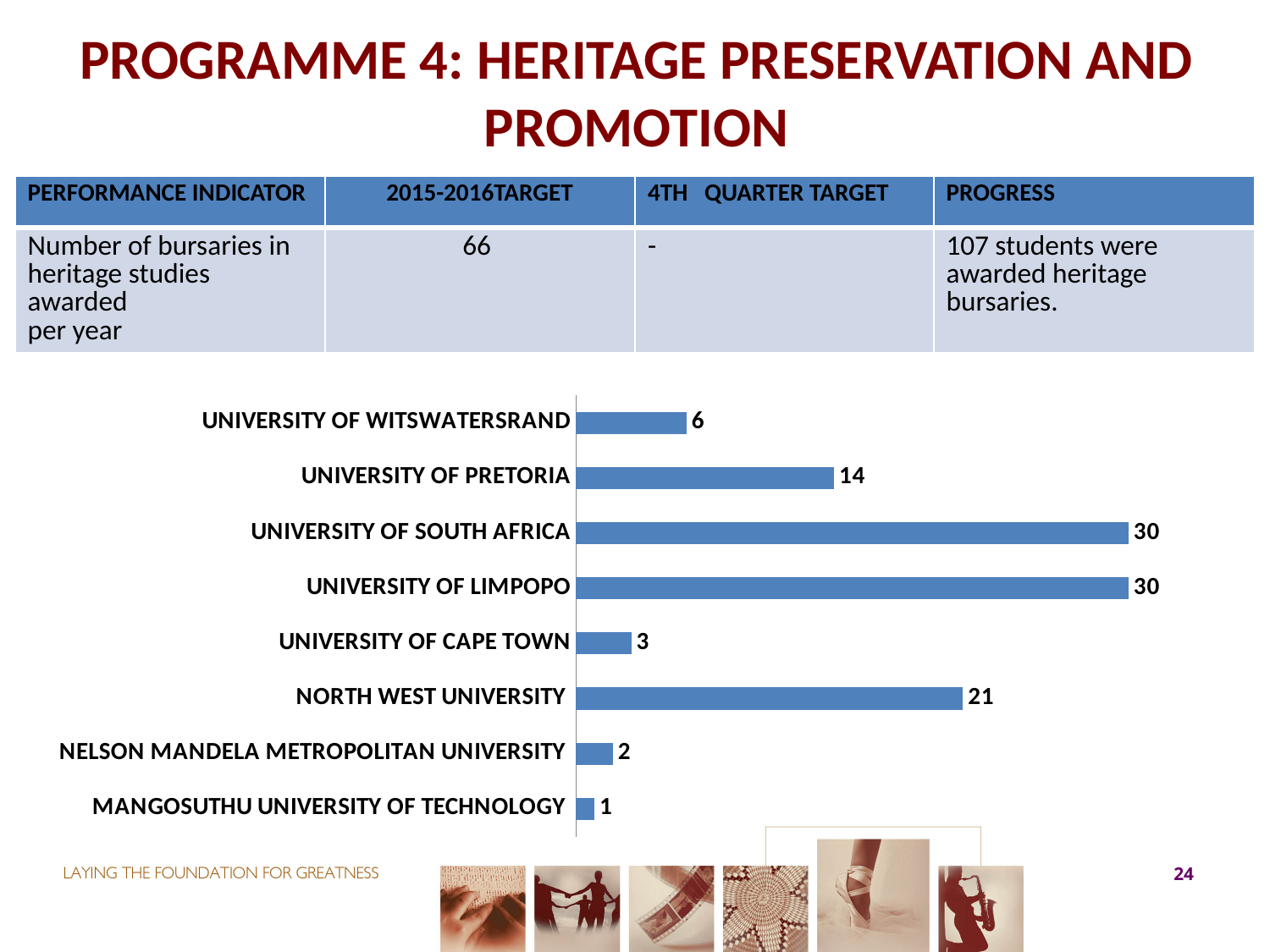
What kind of chart is shown on the slide? bar chart What is the difference between the values for North West University and University of Witswatersrand? 15 What is the value for North West University? 21 What is the value for University of Pretoria? 14 Which has a larger value, University of Witswatersrand or Nelson Mandela Metropolitan University? University of Witswatersrand What is the difference between the values for University of South Africa and University of Pretoria? 16 How many universities are listed in the bar chart? 8 Which has a larger value, North West University or University of Pretoria? North West University What is the total of all the values shown in the bar chart? 107 What is the value for University of Limpopo? 30 Which university has the lowest value in the chart? Mangosuthu University of Technology What is the value for University of Cape Town? 3